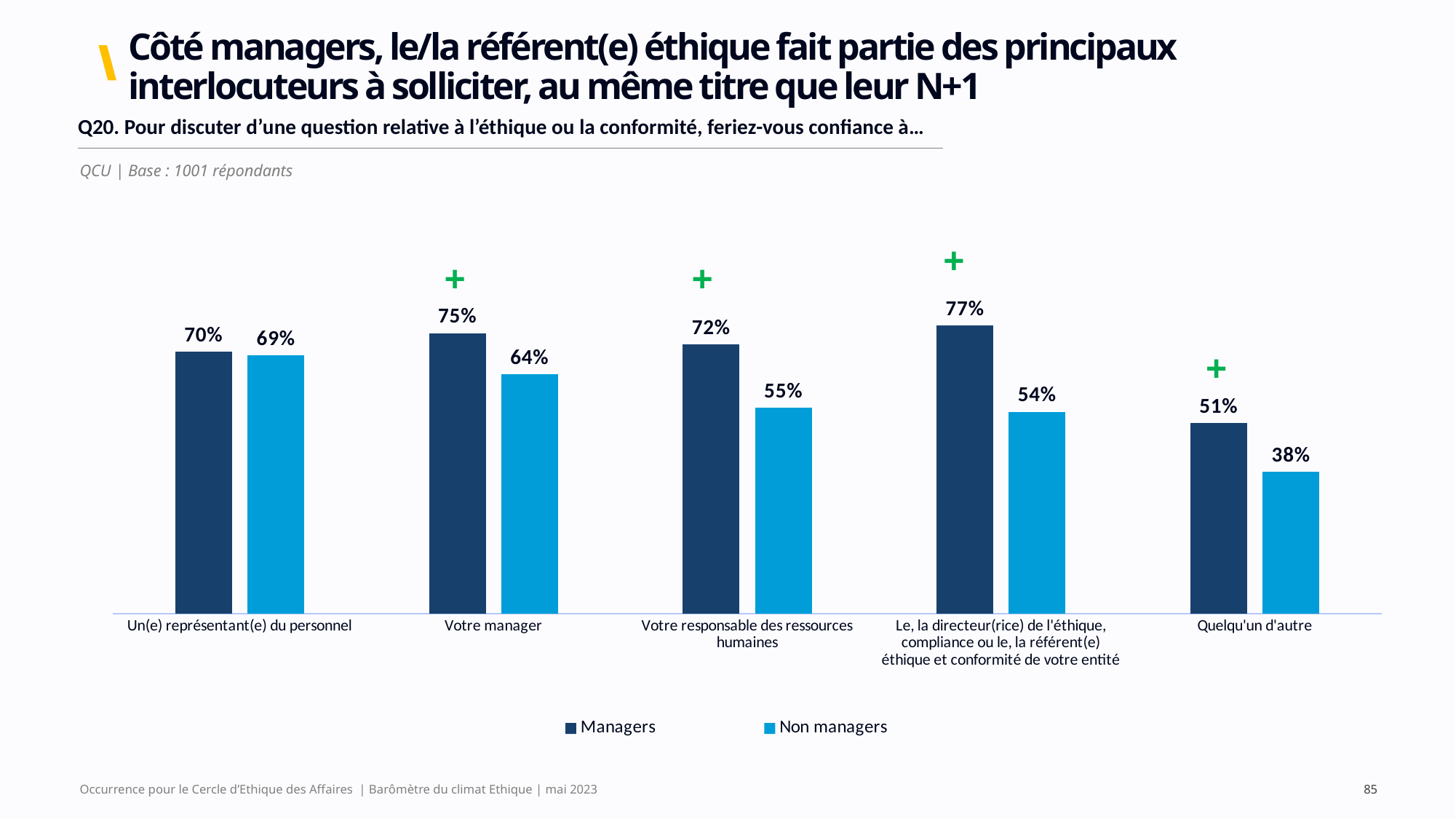
Which is larger: the Managers value for "Votre manager" or the Managers value for "Un(e) représentant(e) du personnel"? Votre manager What is the value for Managers for "Votre manager"? 75% How many categories are shown on the x axis? 5 Which category has the lowest value for Non managers? Quelqu'un d'autre How many series does the legend list? 2 What is the value for Non managers for "Votre responsable des ressources humaines"? 55% What is the value for Non managers for "Quelqu'un d'autre"? 38% What is the difference between the Managers and Non managers values for "Votre responsable des ressources humaines"? 17 percentage points What is the difference between the Managers and Non managers values for "Le, la directeur(rice) de l'éthique, compliance ou le, la référent(e) éthique et conformité de votre entité"? 23 percentage points What kind of chart is shown on the slide? Bar chart Which category has the highest value for Managers? Le, la directeur(rice) de l'éthique, compliance ou le, la référent(e) éthique et conformité de votre entité Which series is shown in dark navy blue? Managers